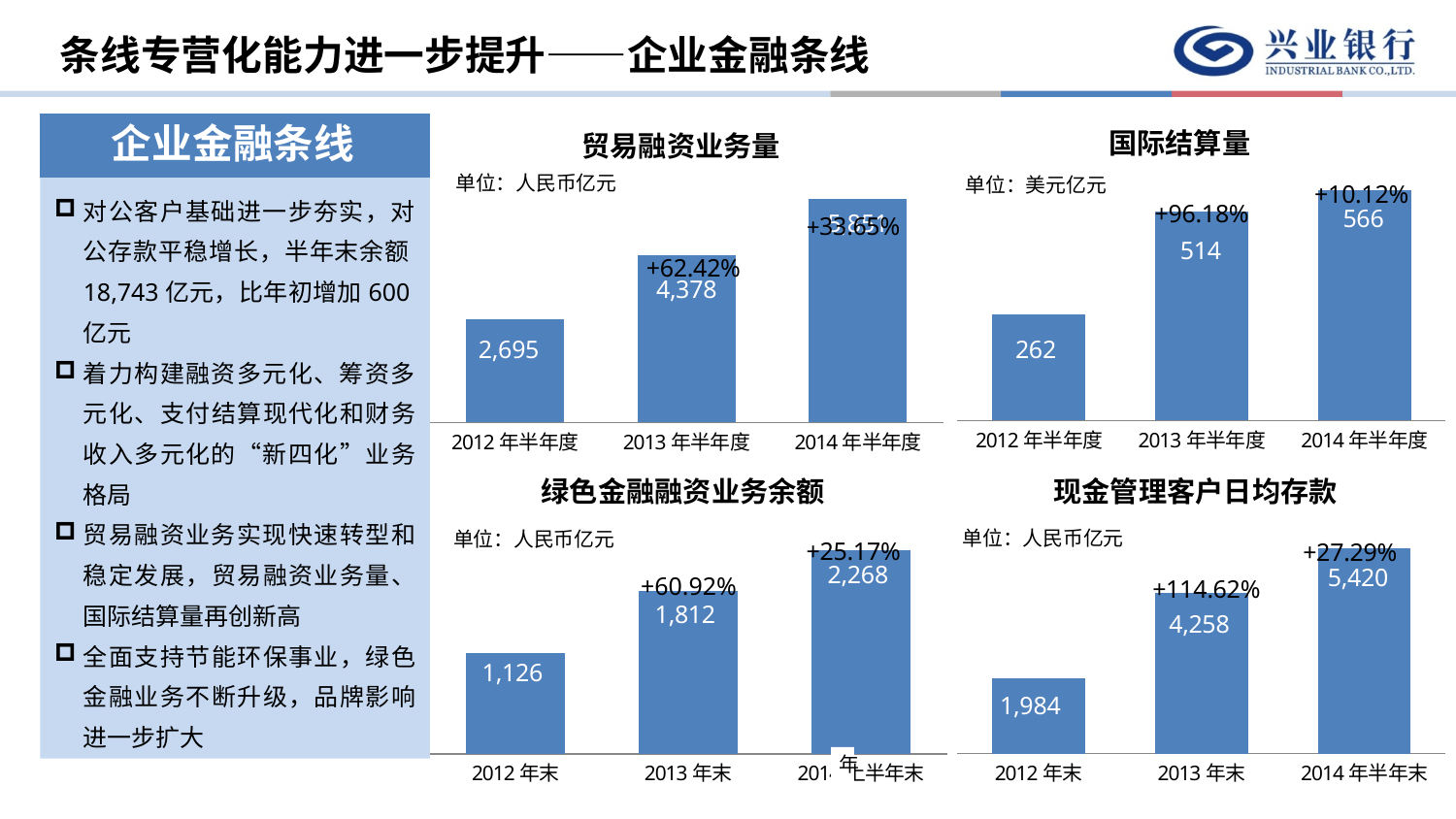
In the 贸易融资业务量 chart, what is the value for 2012年半年度? 2,695 In the 现金管理客户日均存款 chart, which period has the highest value? 2014年半年末 In the 国际结算量 chart, which period has the lowest value? 2012年半年度 In the 绿色金融融资业务余额 chart, what is the value for 2014年上半年末? 2,268 In the 绿色金融融资业务余额 chart, what is the difference between the 2013年末 and 2012年末 values? 686 In the 国际结算量 chart, what is the value for 2013年半年度? 514 What unit is stated for the 国际结算量 chart? 美元亿元 How many bars are in the 现金管理客户日均存款 chart? 3 In the 贸易融资业务量 chart, which is larger, the value for 2012年半年度 or 2013年半年度? 2013年半年度 In the 现金管理客户日均存款 chart, what growth rate is labelled for 2013年末? +114.62% In the 国际结算量 chart, what is the difference between the 2014年半年度 and 2012年半年度 values? 304 What kind of chart is the 绿色金融融资业务余额 chart? Bar chart